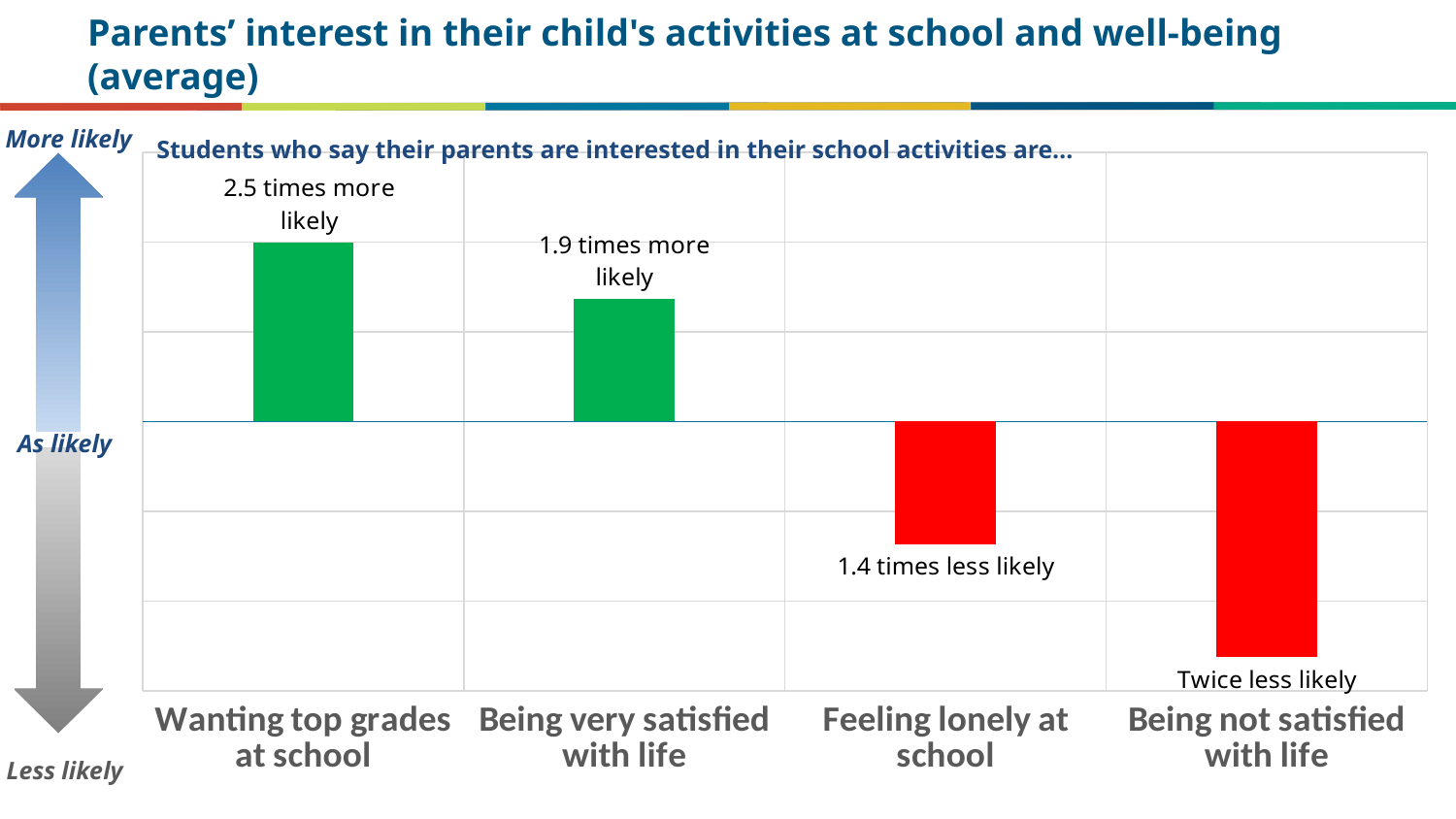
What kind of chart is shown on the slide? Bar chart How many categories are shown on the x axis? 4 What is the data label for 'Being not satisfied with life'? Twice less likely What is the data label for 'Being very satisfied with life'? 1.9 times more likely Which bar is taller above the 'As likely' line: 'Wanting top grades at school' or 'Being very satisfied with life'? Wanting top grades at school What is the title of the chart? Parents' interest in their child's activities at school and well-being (average) Which category has the bar extending furthest below the 'As likely' line? Being not satisfied with life What colour are the bars for the 'less likely' categories? Red What is the data label for 'Wanting top grades at school'? 2.5 times more likely Which category has the tallest bar above the 'As likely' line? Wanting top grades at school Do the bars go from above the 'As likely' line to below it moving left to right along the x axis? Yes What is the data label for 'Feeling lonely at school'? 1.4 times less likely